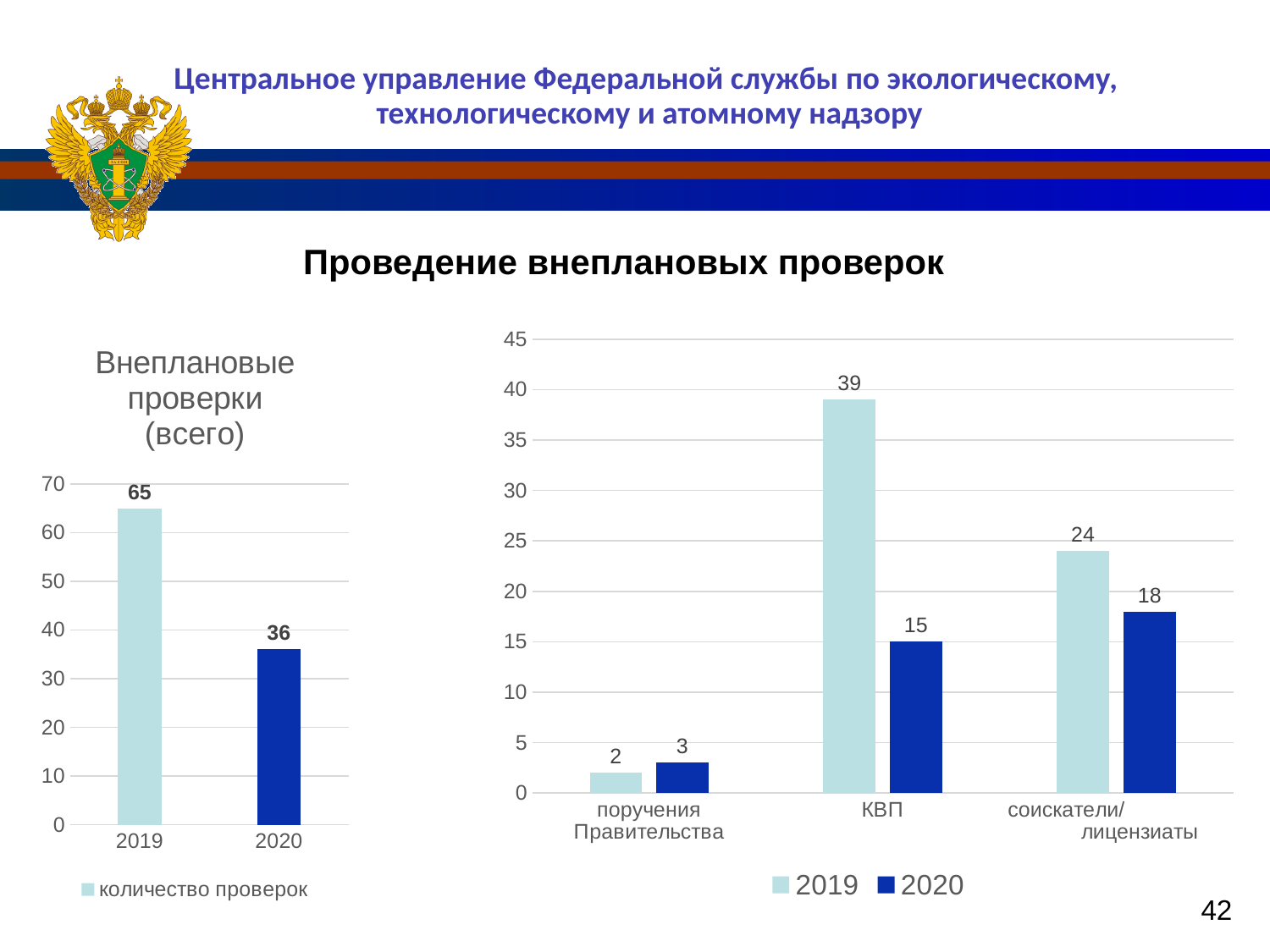
In the right chart, how many categories are shown on the x axis? 3 In the right chart, what is the 2019 value for КВП? 39 In the left chart 'Внеплановые проверки (всего)', what kind of chart is shown? bar chart In the left chart 'Внеплановые проверки (всего)', what is the value for 2020? 36 In the right chart, which category has the lowest 2020 value? поручения Правительства In the right chart, what is the 2020 value for соискатели/лицензиаты? 18 In the right chart, what is the difference between the 2019 and 2020 values for КВП? 24 In the left chart 'Внеплановые проверки (всего)', what is the difference between the 2019 and 2020 values? 29 In the right chart, how many series does the legend list? 2 In the right chart, which category has the highest 2019 value? КВП In the right chart, what is the 2020 value for поручения Правительства? 3 In the left chart 'Внеплановые проверки (всего)', what is the value for 2019? 65